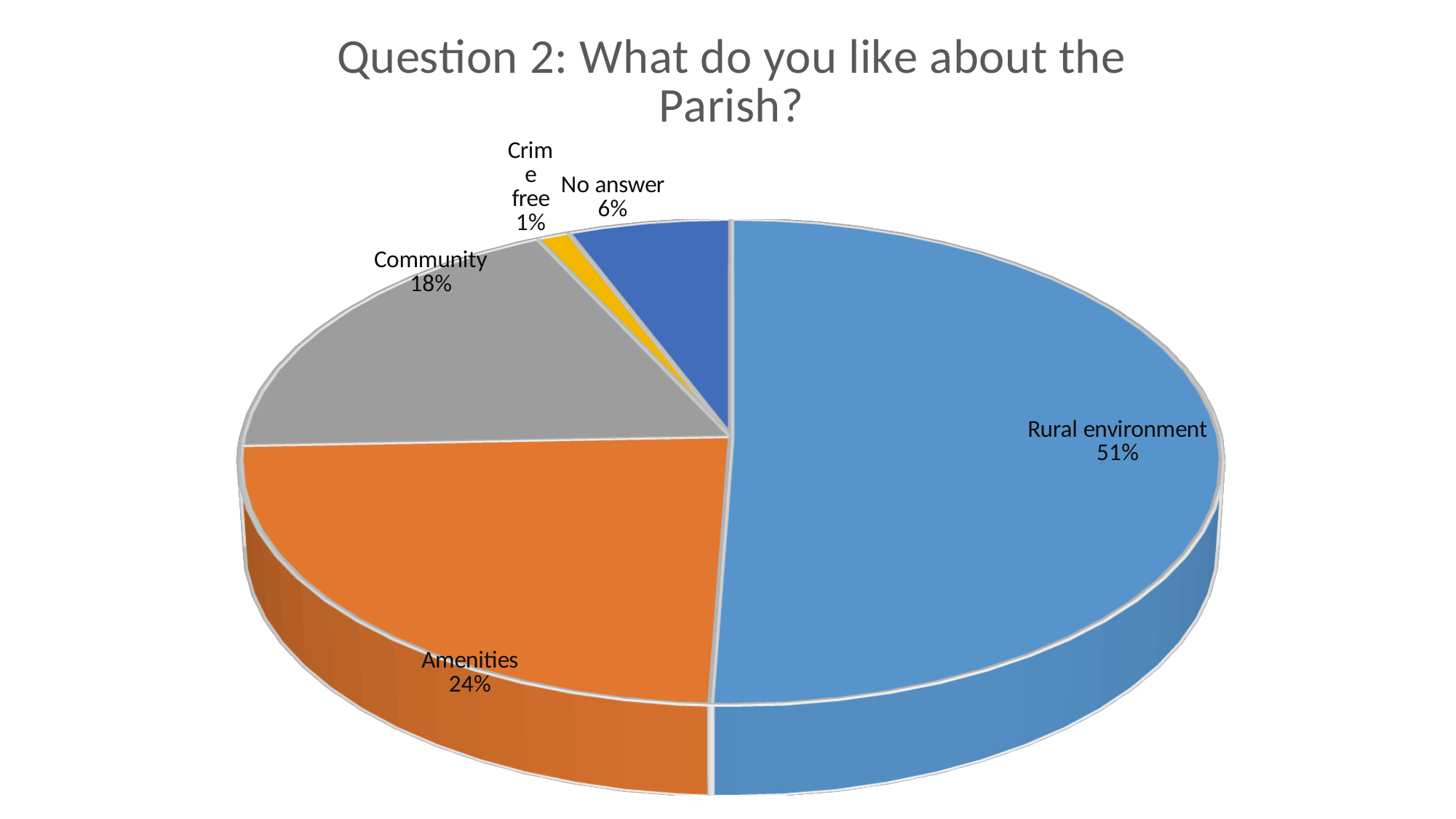
What kind of chart is shown on the slide? Pie chart What share of the pie is Community? 18% What share of the pie is Amenities? 24% What is the title of the chart? Question 2: What do you like about the Parish? Which category has the smallest slice of the pie? Crime free Which is larger, the Community slice or the No answer slice? Community What share of the pie is Rural environment? 51% What is the difference in percentage points between Rural environment and Amenities? 27 Which category has the largest slice of the pie? Rural environment How many categories are shown in the pie chart? 5